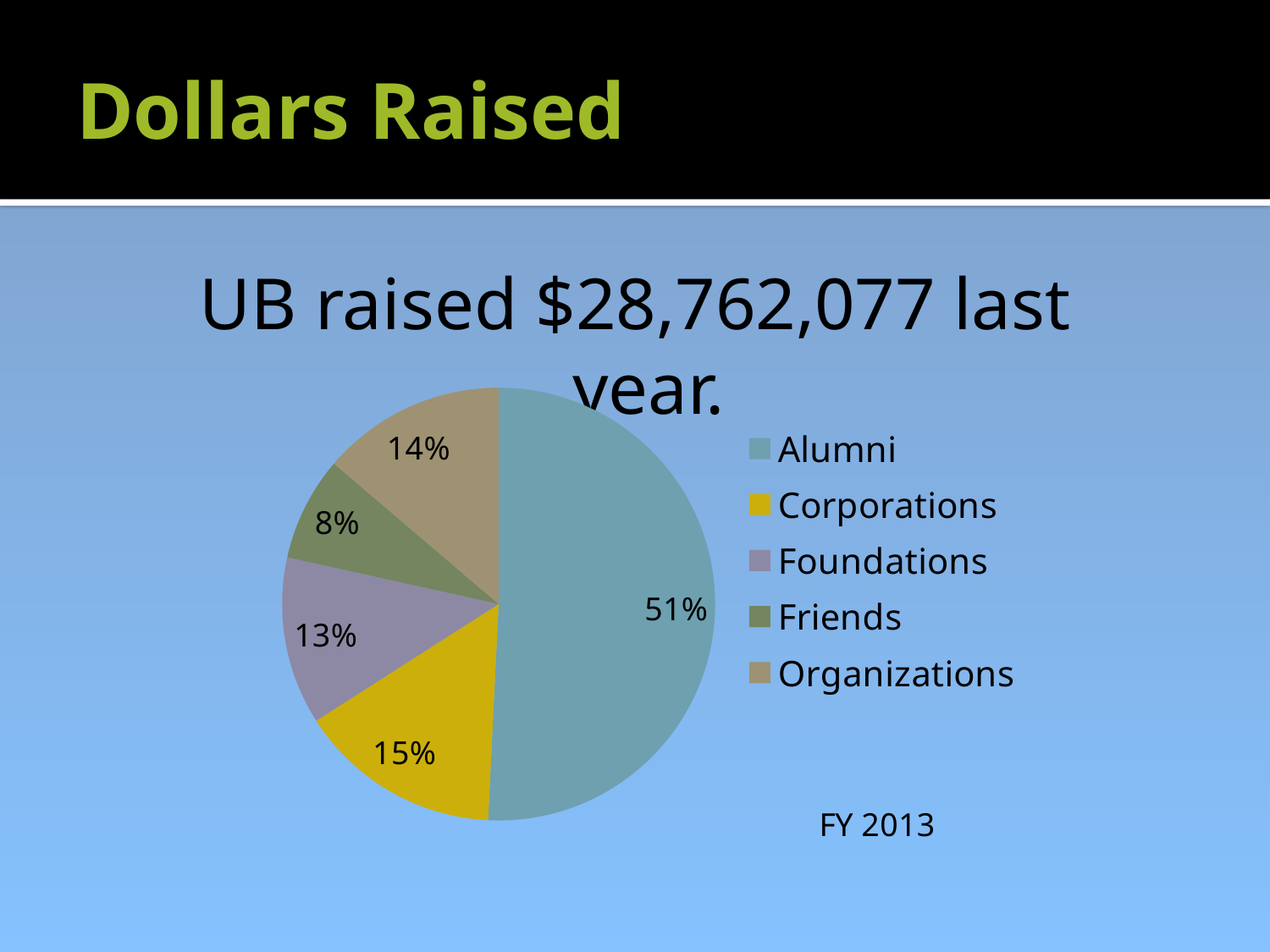
How many percentage points larger is the Alumni share than the Corporations share? 36 What share of dollars raised came from Foundations? 13% How many categories does the legend list? 5 What share of dollars raised came from Corporations? 15% What fiscal year is noted below the legend? FY 2013 What share of dollars raised came from Friends? 8% Which source accounts for the smallest share of the pie? Friends Which source accounts for the largest share of the pie? Alumni What kind of chart is shown on the slide? pie chart What share of dollars raised came from Alumni? 51% Which is larger, the share for Organizations or the share for Friends? Organizations What share of dollars raised came from Organizations? 14%